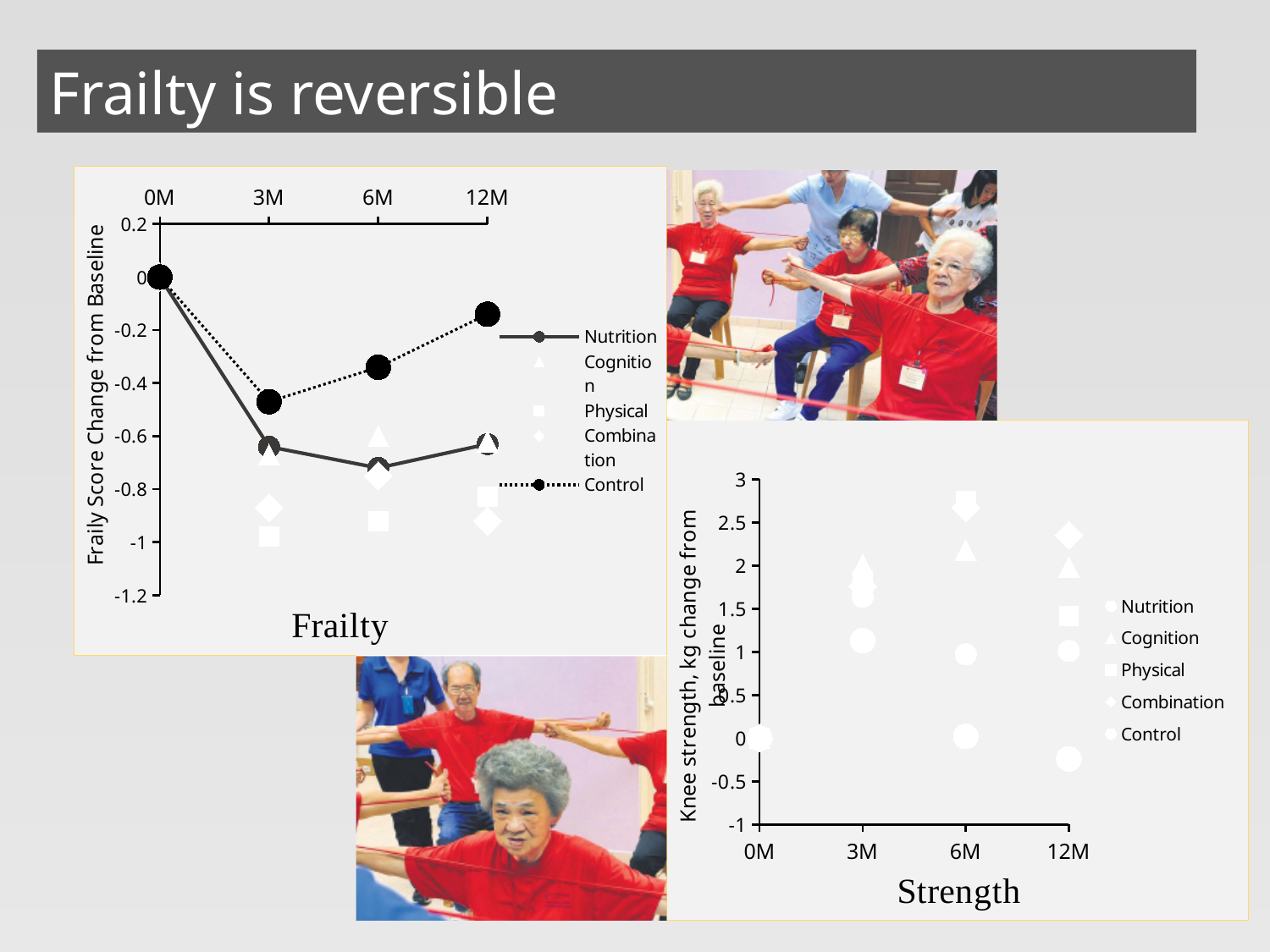
In the Frailty chart, is the Control value at 12M greater or less than -0.2? greater In the Strength chart, is the Control value at 12M greater or less than 0? less How many time points are shown on the x axis of the Frailty chart? 4 What kind of chart is the Frailty chart on the left? line chart In the Strength chart, which series has the lowest value at 12M? Control In the Frailty chart, is the Nutrition value at 6M greater or less than -0.6? less How many series does the legend of the Strength chart list? 5 What is the y-axis label of the Strength chart? Knee strength, kg change from baseline In the Frailty chart, which is higher at 12M, Control or Nutrition? Control In the Strength chart, which series has the highest value at 12M? Combination